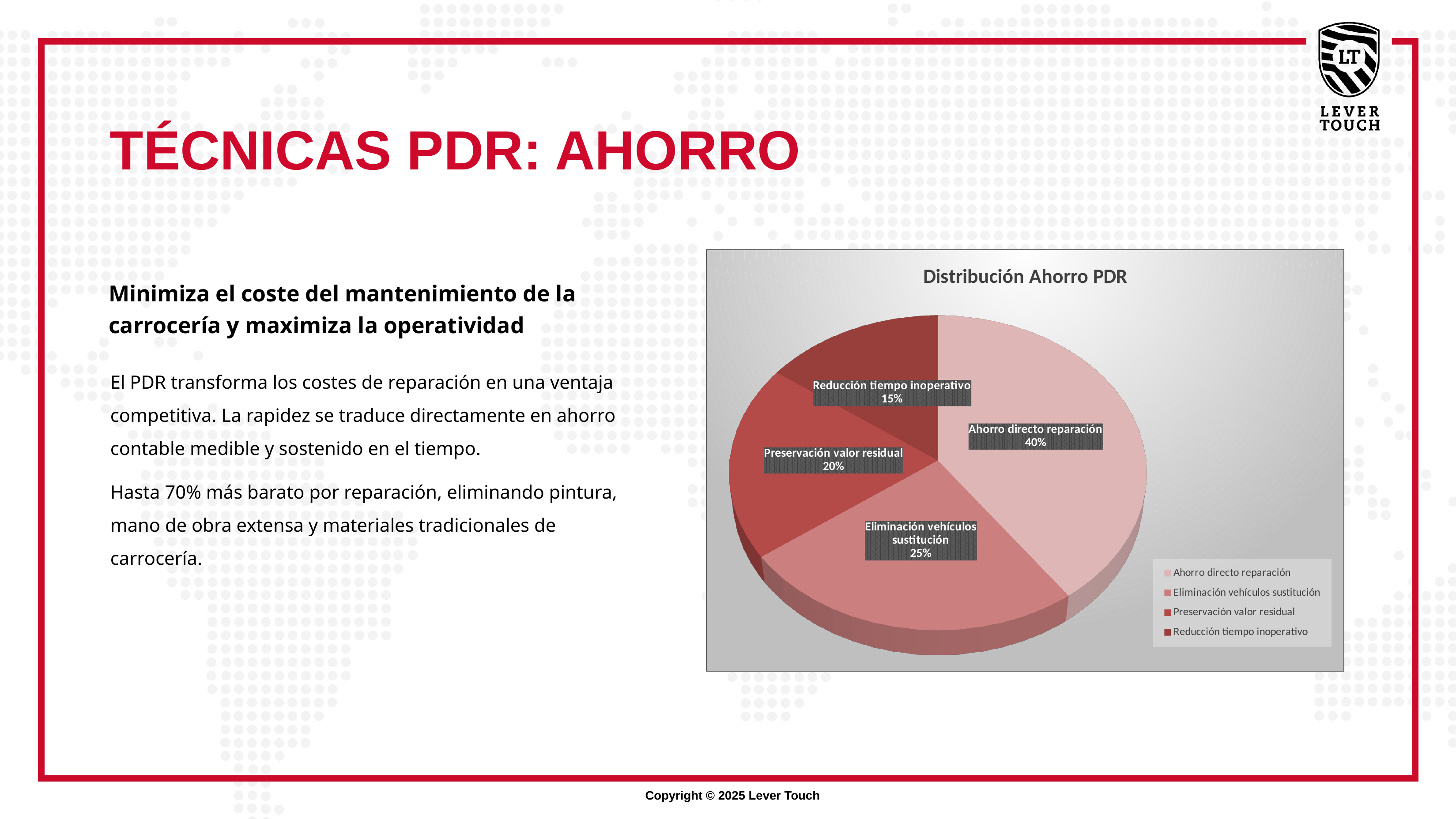
How many categories does the pie chart have? 4 What is the value shown for Preservación valor residual? 20% Which is larger, Preservación valor residual or Reducción tiempo inoperativo? Preservación valor residual Which category has the largest slice of the pie? Ahorro directo reparación What is the value shown for Reducción tiempo inoperativo? 15% Which category has the smallest slice of the pie? Reducción tiempo inoperativo How many entries does the legend list? 4 What is the title of the chart? Distribución Ahorro PDR What is the value shown for Eliminación vehículos sustitución? 25% What kind of chart is shown on the slide? pie chart What share of the pie does Ahorro directo reparación represent? 40% What is the difference between the values for Ahorro directo reparación and Eliminación vehículos sustitución? 15%